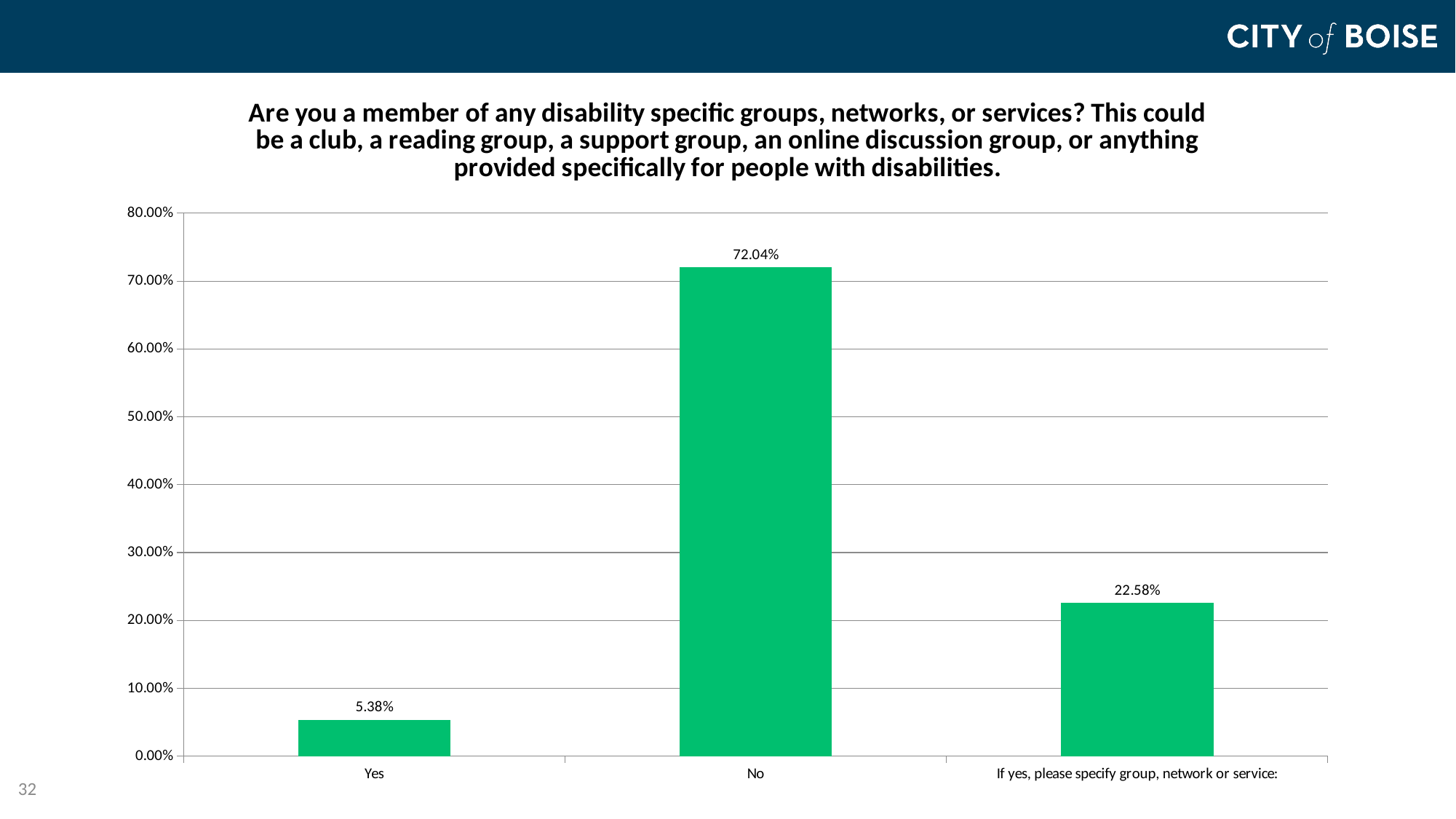
Is the value for "No" greater or less than 70.00%? greater What is the difference between the values for "No" and "Yes"? 66.66% What is the value for "Yes"? 5.38% Which category has the lowest value? Yes What is the highest value shown on the y axis? 80.00% Which is larger, the value for "Yes" or the value for "If yes, please specify group, network or service:"? If yes, please specify group, network or service: What is the value for "No"? 72.04% How many categories are shown on the x axis? 3 What is the difference between the values for "No" and "If yes, please specify group, network or service:"? 49.46% What kind of chart is shown on the slide? Bar chart What is the value for "If yes, please specify group, network or service:"? 22.58% Which category has the highest value? No